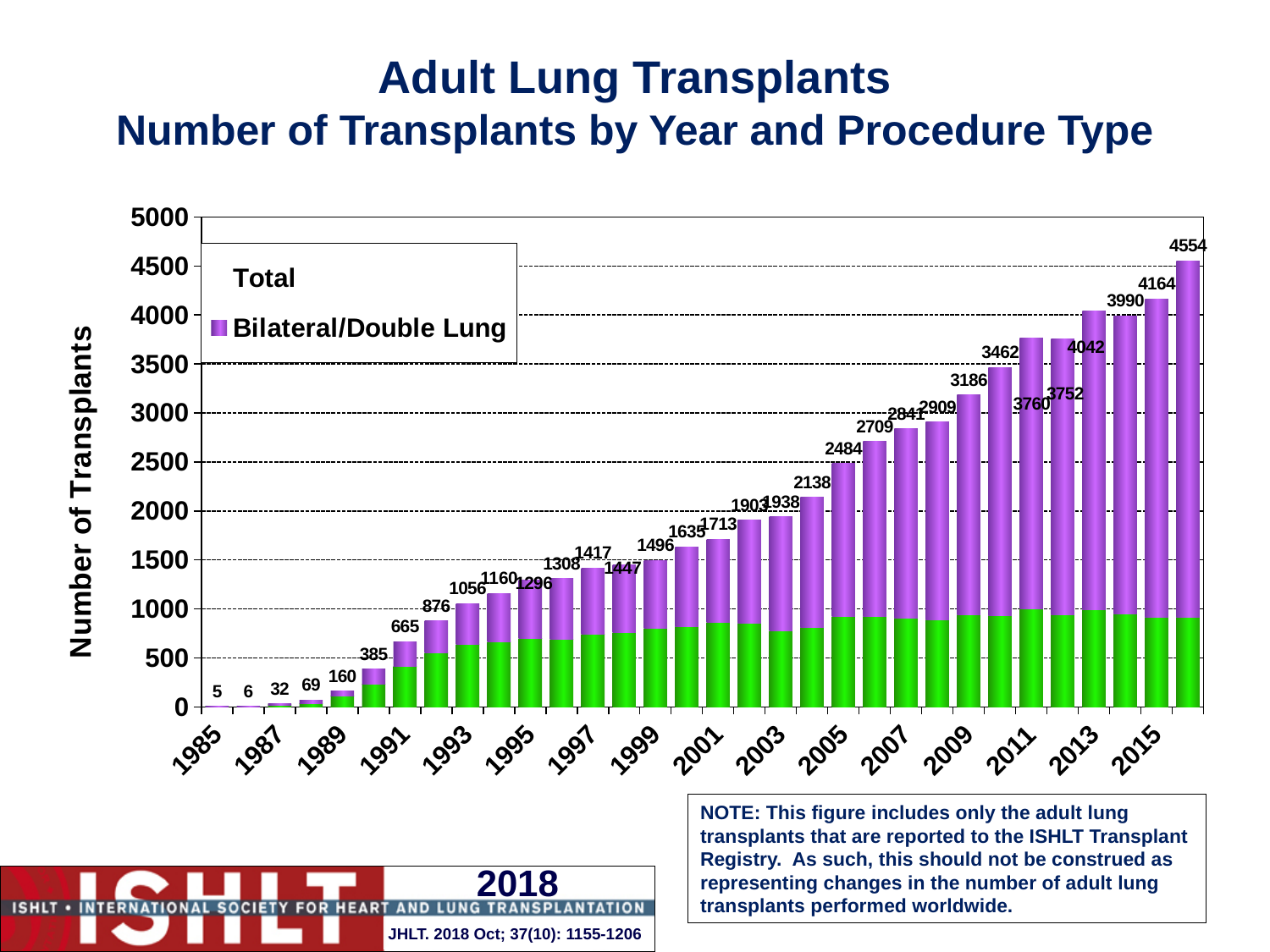
How many entries does the legend list? 2 Which year has a larger total, 2013 or 2014? 2013 Which year has the lowest total number of transplants? 1985 Which year has the highest total number of transplants? 2016 What is the difference between the total for 2016 and the total for 2015? 390 What is the total number of transplants shown for 1990? 385 What kind of chart is shown on the slide? Stacked bar chart What is the total number of transplants shown for 2005? 2484 How many years (bars) are plotted in the chart? 32 What is the total number of adult lung transplants shown for 2016? 4554 Is the total for 2010 greater or less than 3500? less Do the total number of transplants generally rise or fall from 1985 to 2016? Rise